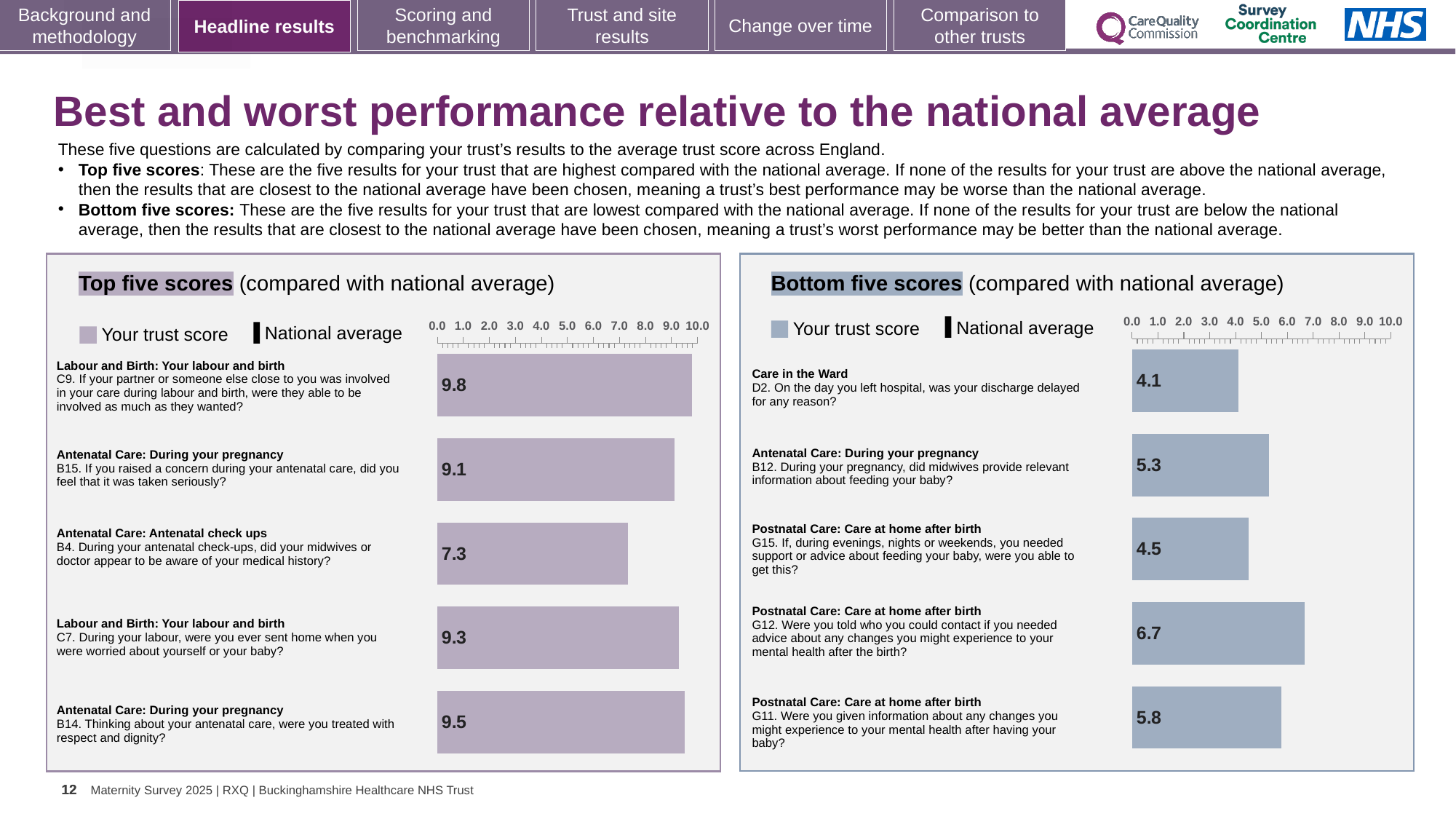
In the Bottom five scores chart, which has the larger trust score, B12 or G11? G11 (5.8) In the Top five scores chart, which question has the highest trust score? C9 (9.8) In the Bottom five scores chart, what is the trust score for G12 (told who to contact about mental health changes after the birth)? 6.7 In the Top five scores chart, which question has the lowest trust score? B4 (7.3) How many questions are shown in the Bottom five scores chart? 5 In the Bottom five scores chart, which question has the lowest trust score? D2 (4.1) In the Top five scores chart, is the trust score for B15 greater or less than 8.0? greater In the Bottom five scores chart, which question has the highest trust score? G12 (6.7) What kind of chart is used in the Top five scores panel? bar chart In the Bottom five scores chart, what is the difference between the scores for G12 and D2? 2.6 In the Top five scores chart, what is the trust score for C9 (partner involved as much as they wanted during labour and birth)? 9.8 In the Top five scores chart, what is the difference between the scores for C9 and B4? 2.5